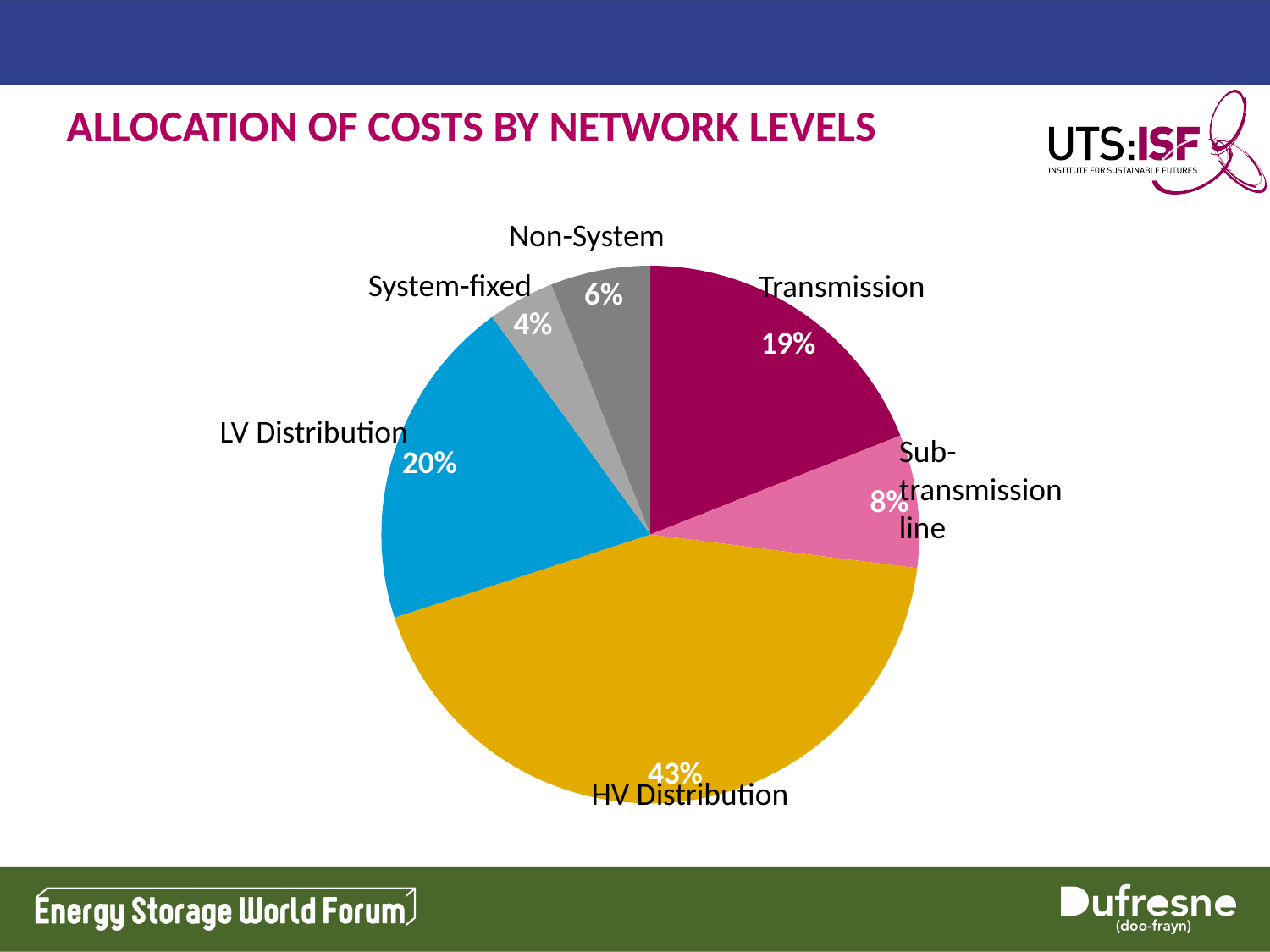
What is the difference in percentage points between HV Distribution and LV Distribution? 23 What share of costs is allocated to Non-System? 6% Which has a larger share of costs, Transmission or Sub-transmission line? Transmission How many slices does the pie chart have? 6 Which network level has the smallest share of costs? System-fixed What share of costs is allocated to LV Distribution? 20% Which network level has the largest share of costs? HV Distribution What share of costs is allocated to the Sub-transmission line? 8% What share of costs is allocated to HV Distribution? 43% What kind of chart is shown on the slide? pie chart What is the title of the chart on the slide? ALLOCATION OF COSTS BY NETWORK LEVELS What share of costs is allocated to Transmission? 19%